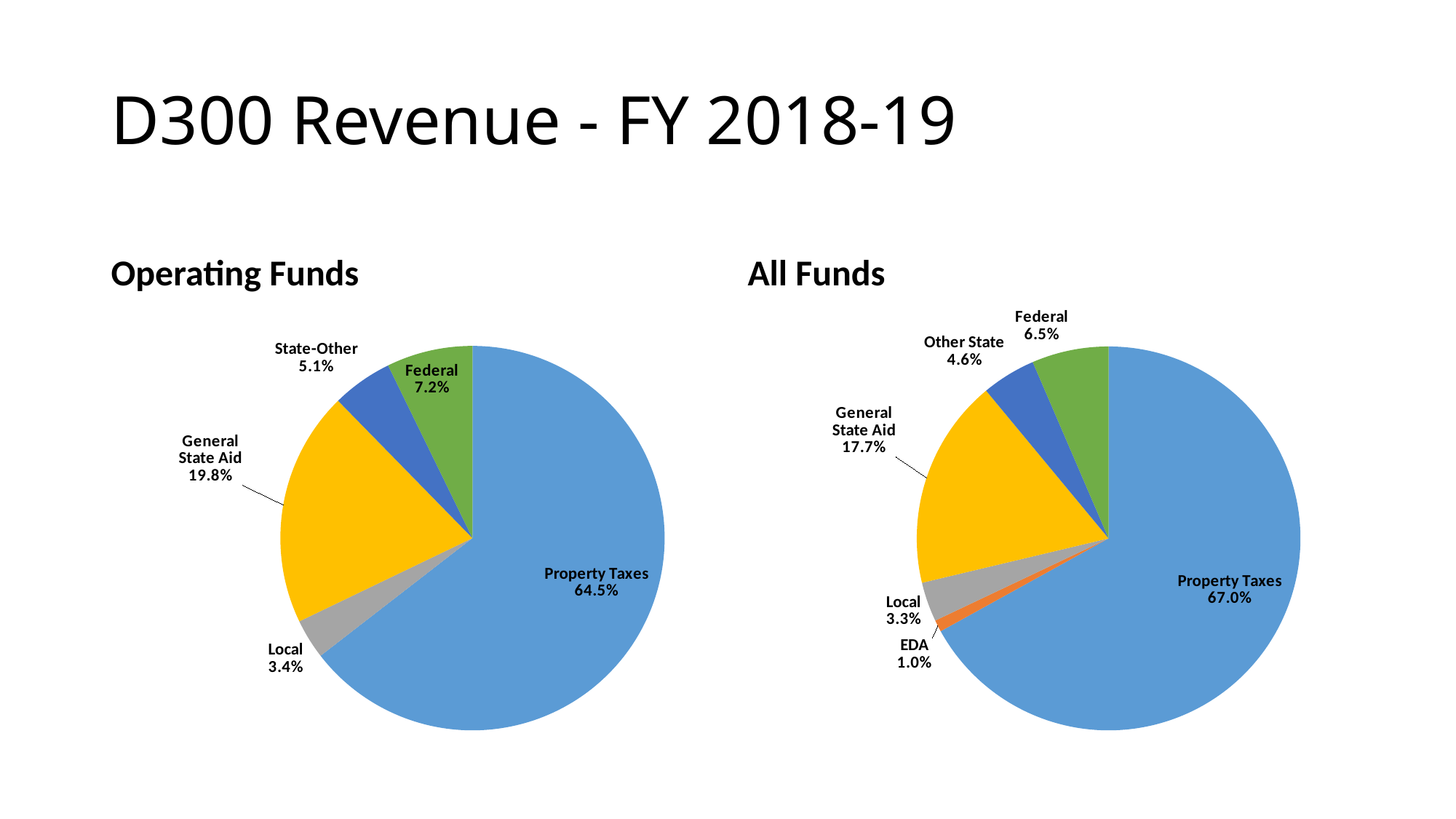
How many categories are shown in the All Funds chart? 6 In the All Funds chart, what share of revenue comes from General State Aid? 17.7% In the Operating Funds chart, which category has the smallest share? Local How many categories are shown in the Operating Funds chart? 5 In the All Funds chart, which category has the smallest share? EDA In the Operating Funds chart, what share of revenue comes from Property Taxes? 64.5% What is the difference between the Property Taxes share in the All Funds chart and the Property Taxes share in the Operating Funds chart? 2.5% In the Operating Funds chart, what is the value for State-Other? 5.1% In the Operating Funds chart, which category has the largest share? Property Taxes In the Operating Funds chart, which is larger: Federal or State-Other? Federal In the All Funds chart, what is the value for EDA? 1.0% What type of chart is used for the Operating Funds data? Pie chart